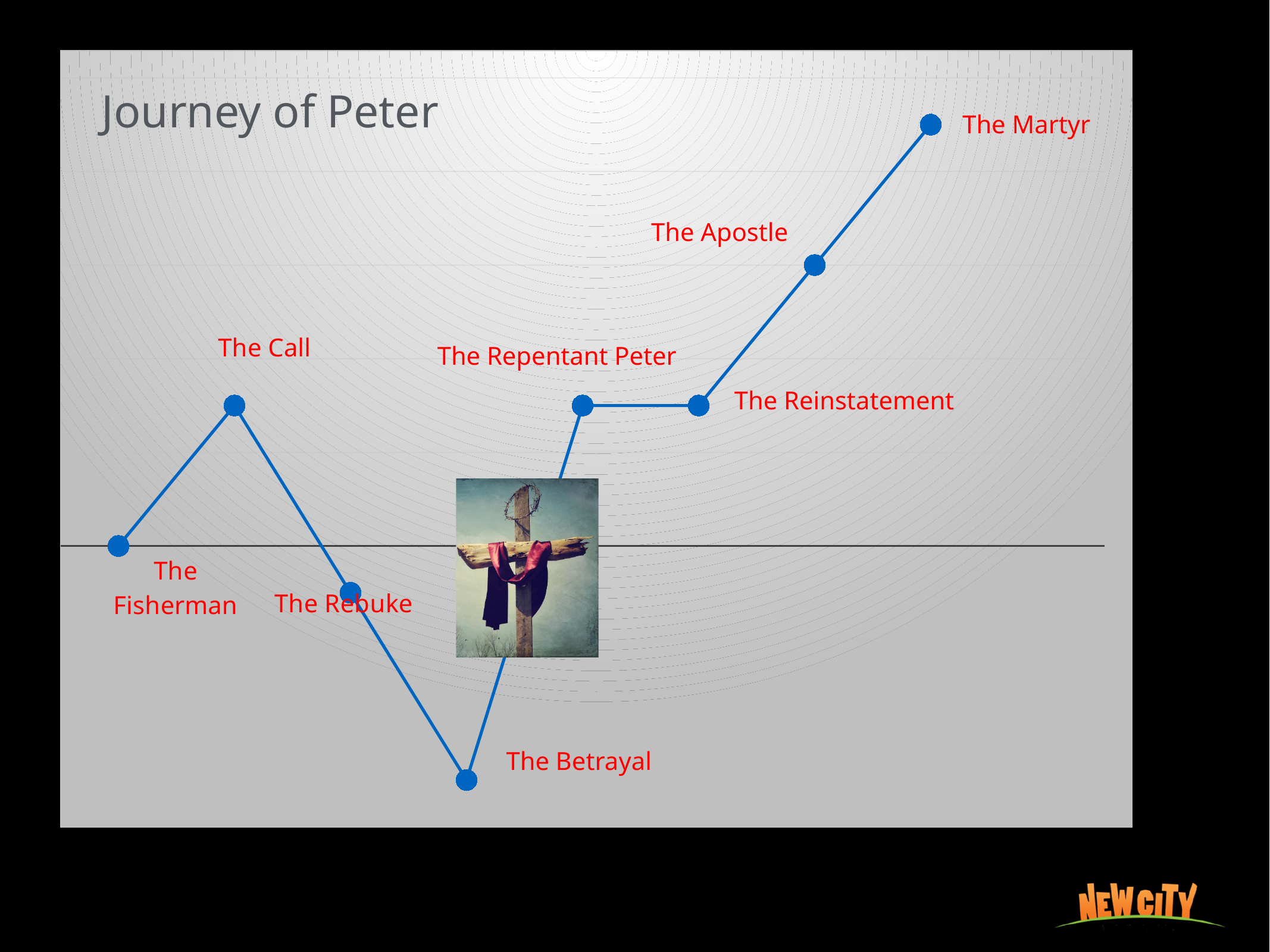
Which is higher on the chart, The Martyr or The Reinstatement? The Martyr Which labelled point is the highest on the chart? The Martyr Which is higher on the chart, The Call or The Rebuke? The Call Does the line rise or fall from The Call to The Betrayal? fall Which is higher on the chart, The Apostle or The Call? The Apostle What is the title of the chart? Journey of Peter Which labelled point is the lowest on the chart? The Betrayal What kind of chart is shown on the slide? line chart Which labelled point comes first along the line, at the far left? The Fisherman How many labelled points are plotted on the line? 8 Does the line rise or fall from The Reinstatement to The Martyr? rise